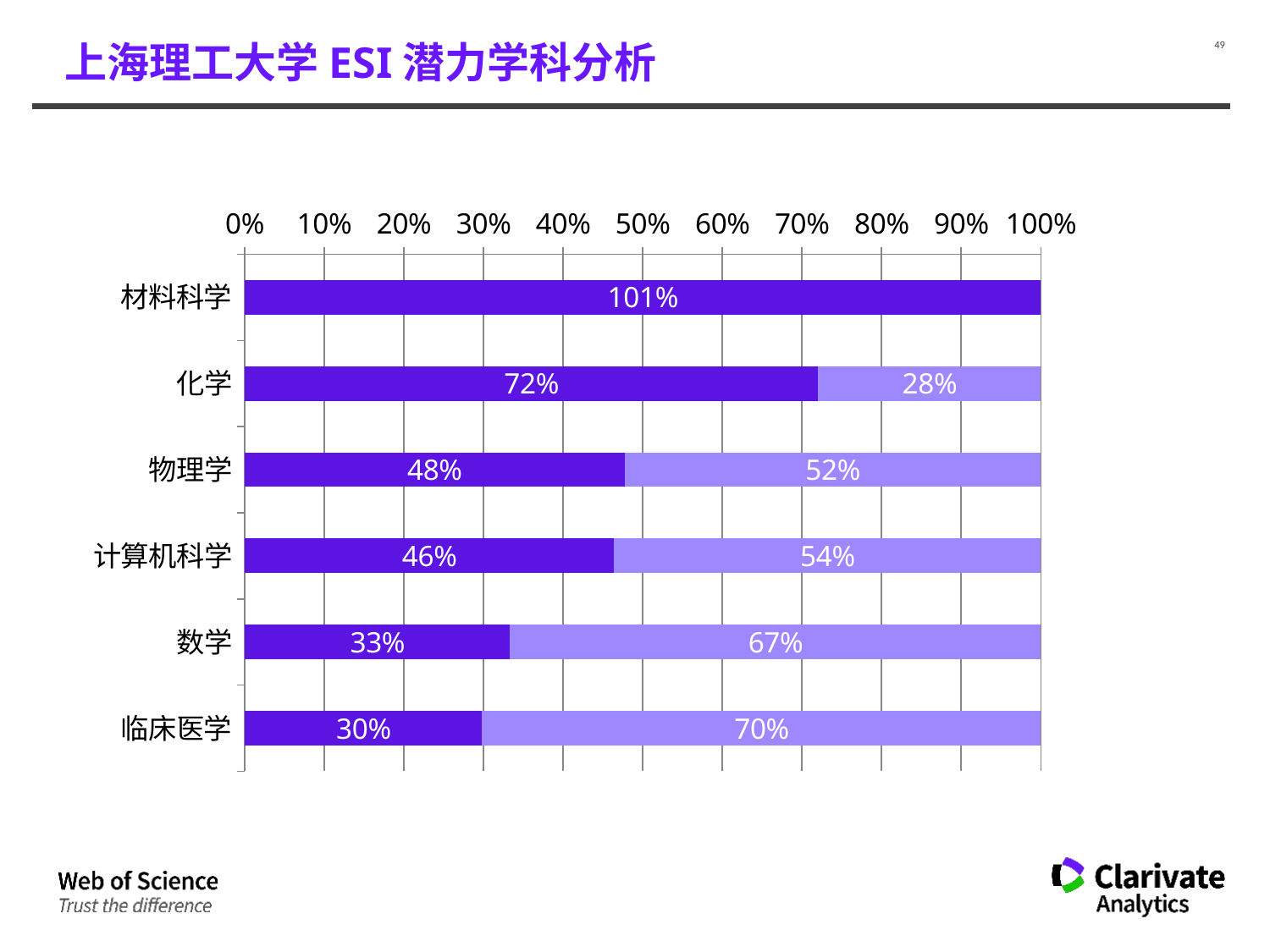
How many categories are shown on the chart? 6 Which has a larger dark purple value, 物理学 or 计算机科学? 物理学 What is the light purple value for 物理学? 52% What is the dark purple value for 材料科学? 101% What is the dark purple value for 临床医学? 30% Which category has the highest dark purple value? 材料科学 What is the total of the stacked bar for 计算机科学? 100% What is the dark purple value for 化学? 72% Is the dark purple value for 数学 greater or less than 40%? less What is the difference between the dark purple values for 化学 and 数学? 39% What kind of chart is shown on the slide? Stacked horizontal bar chart Which category has the lowest dark purple value? 临床医学